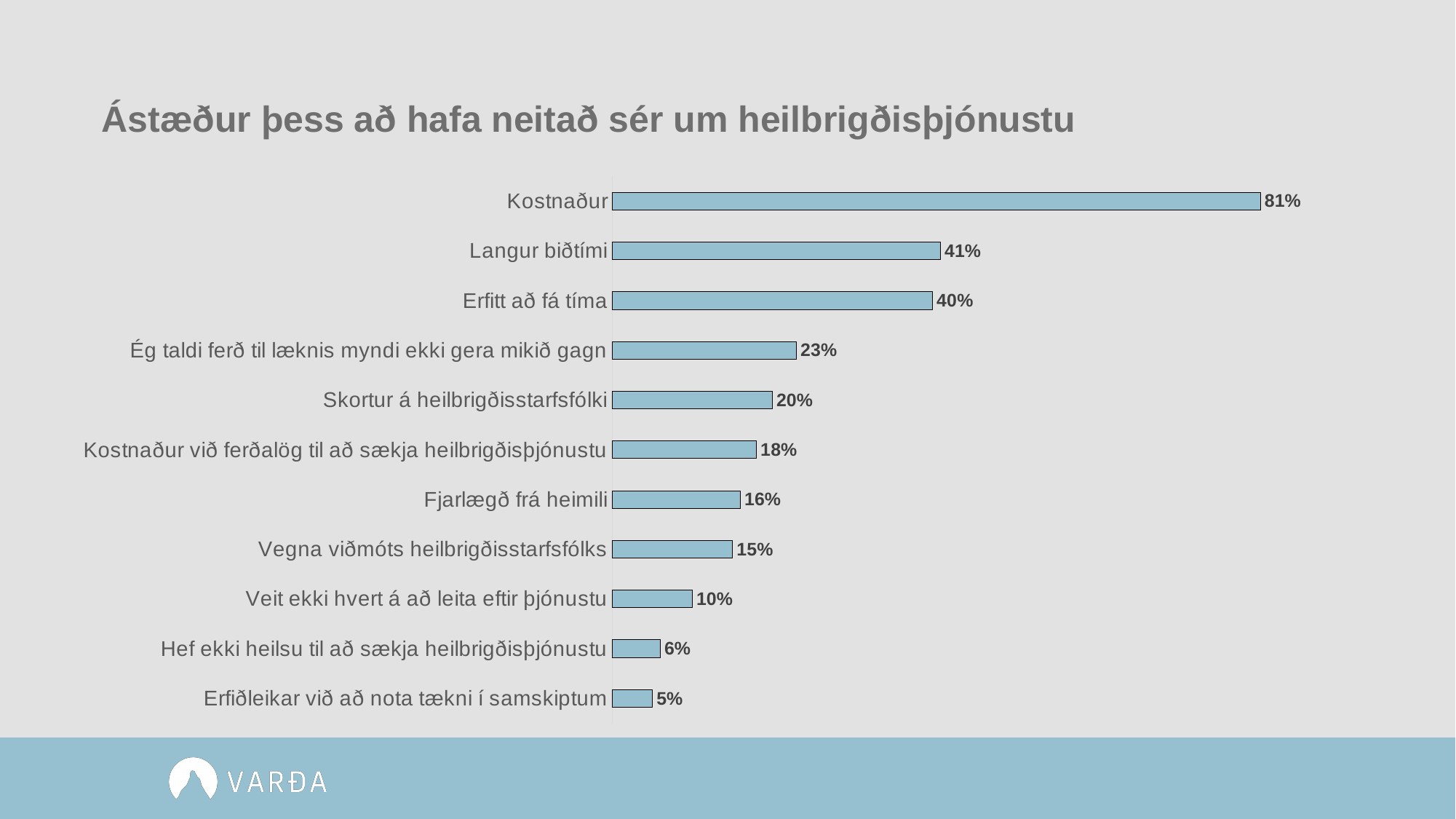
Which is larger, the value for Ég taldi ferð til læknis myndi ekki gera mikið gagn or the value for Kostnaður við ferðalög til að sækja heilbrigðisþjónustu? Ég taldi ferð til læknis myndi ekki gera mikið gagn What is the value for Vegna viðmóts heilbrigðisstarfsfólks? 15% What is the value for Kostnaður? 81% Which category has the highest value? Kostnaður Which category has the lowest value? Erfiðleikar við að nota tækni í samskiptum What is the value for Veit ekki hvert á að leita eftir þjónustu? 10% What is the value for Skortur á heilbrigðisstarfsfólki? 20% What is the title of the chart? Ástæður þess að hafa neitað sér um heilbrigðisþjónustu What is the difference between the values for Fjarlægð frá heimili and Hef ekki heilsu til að sækja heilbrigðisþjónustu? 10% How many categories are shown in the chart? 11 What is the difference between the values for Kostnaður and Langur biðtími? 40% What kind of chart is shown on the slide? Bar chart